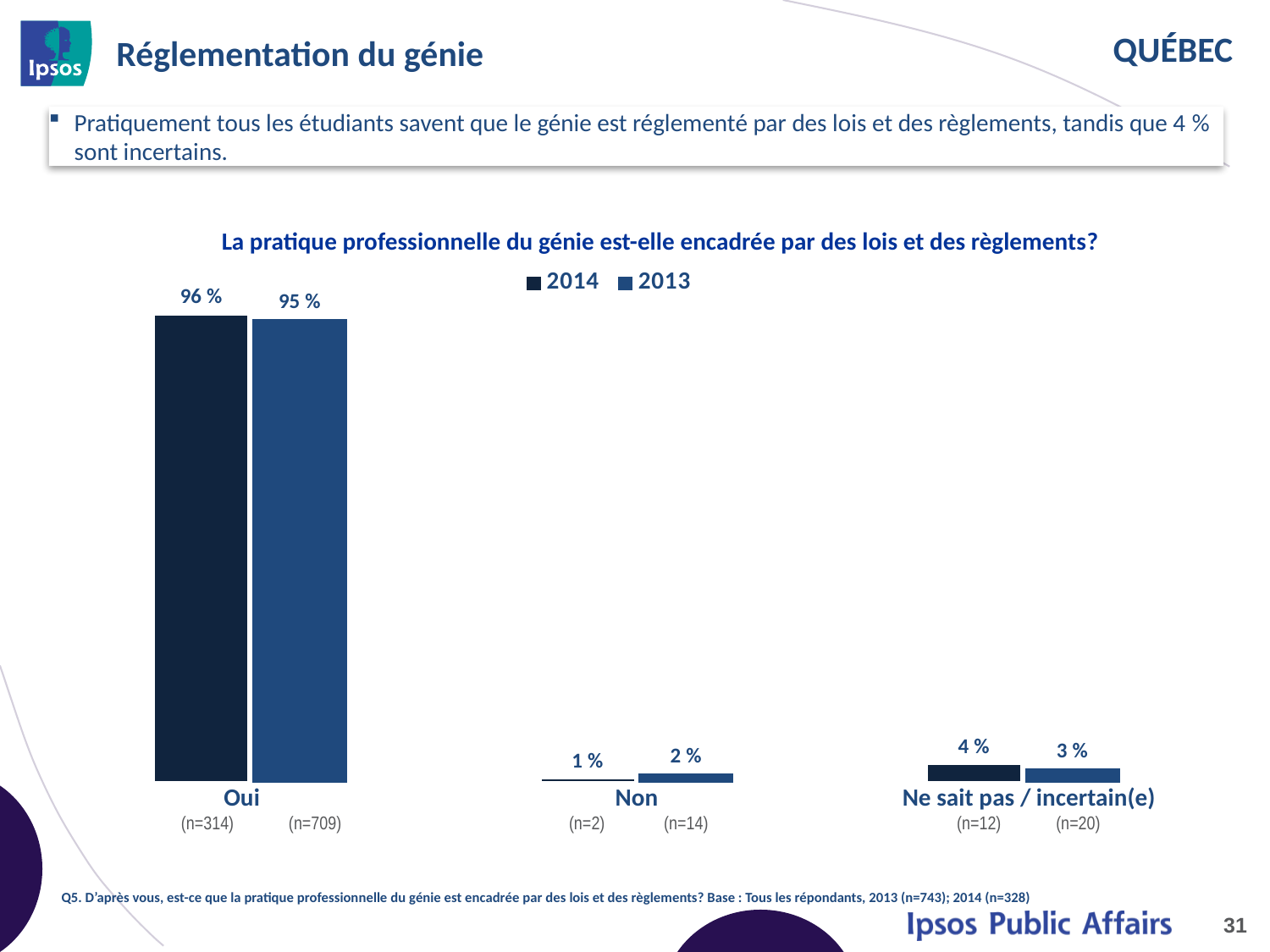
How many series does the legend list? 2 What is the 2013 value for "Oui"? 95 % Which category has the lowest value for 2013? Non Which is larger for "Non": the 2014 value or the 2013 value? 2013 How many categories are shown on the x axis? 3 What is the 2013 value for "Ne sait pas / incertain(e)"? 3 % Which category has the highest value for 2014? Oui What is the 2014 value for "Oui"? 96 % What is the difference between the 2014 and 2013 values for "Ne sait pas / incertain(e)"? 1 % What is the 2014 value for "Non"? 1 % What kind of chart is shown? Bar chart What is the title of the chart? La pratique professionnelle du génie est-elle encadrée par des lois et des règlements?